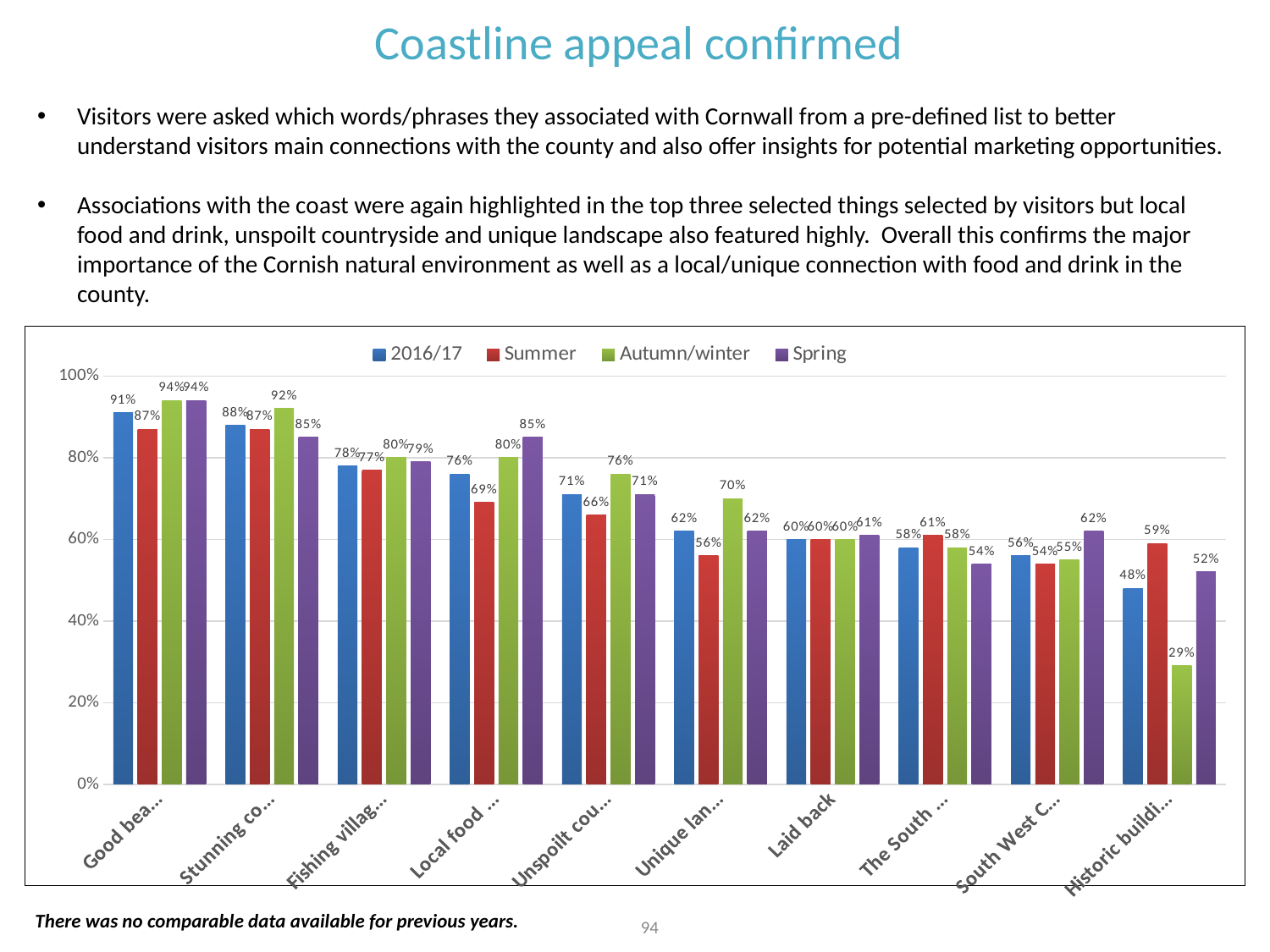
What is the Spring value for the 'Laid back' category? 61% For the 'Laid back' category, which series has the highest value? Spring For the rightmost category on the chart, which series has the lowest value? Autumn/winter What kind of chart is shown on the slide? bar chart What is the Autumn/winter value for the leftmost category on the chart? 94% How many categories are plotted along the x axis of the chart? 10 What are the series names listed in the chart legend? 2016/17, Summer, Autumn/winter, Spring How many series does the chart legend list? 4 What is the Summer value for the 'Laid back' category? 60% What is the 2016/17 value for the 'Laid back' category? 60% What is the Autumn/winter value for the rightmost category on the chart? 29% Is the Autumn/winter value for 'Laid back' greater or less than 40%? greater